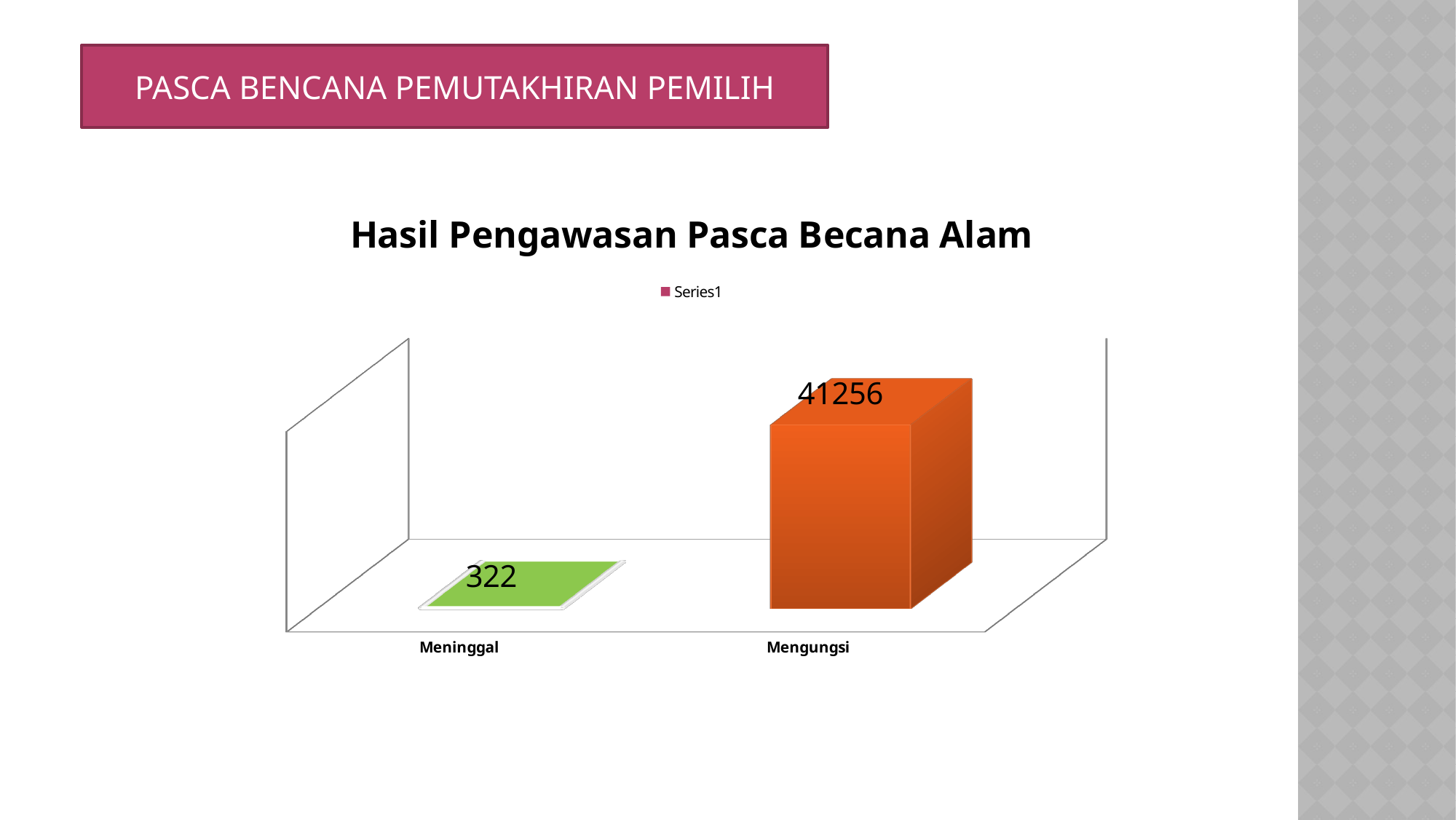
How many categories are shown on the x axis? 2 What kind of chart is shown on the slide? bar chart What is the value for Meninggal? 322 Which category has the lowest value? Meninggal Which is larger, the value for Meninggal or the value for Mengungsi? Mengungsi What is the name of the series listed in the legend? Series1 What is the title of the chart? Hasil Pengawasan Pasca Becana Alam What is the difference between the values for Mengungsi and Meninggal? 40934 How many series does the legend list? 1 What is the value for Mengungsi? 41256 Which category has the highest value? Mengungsi